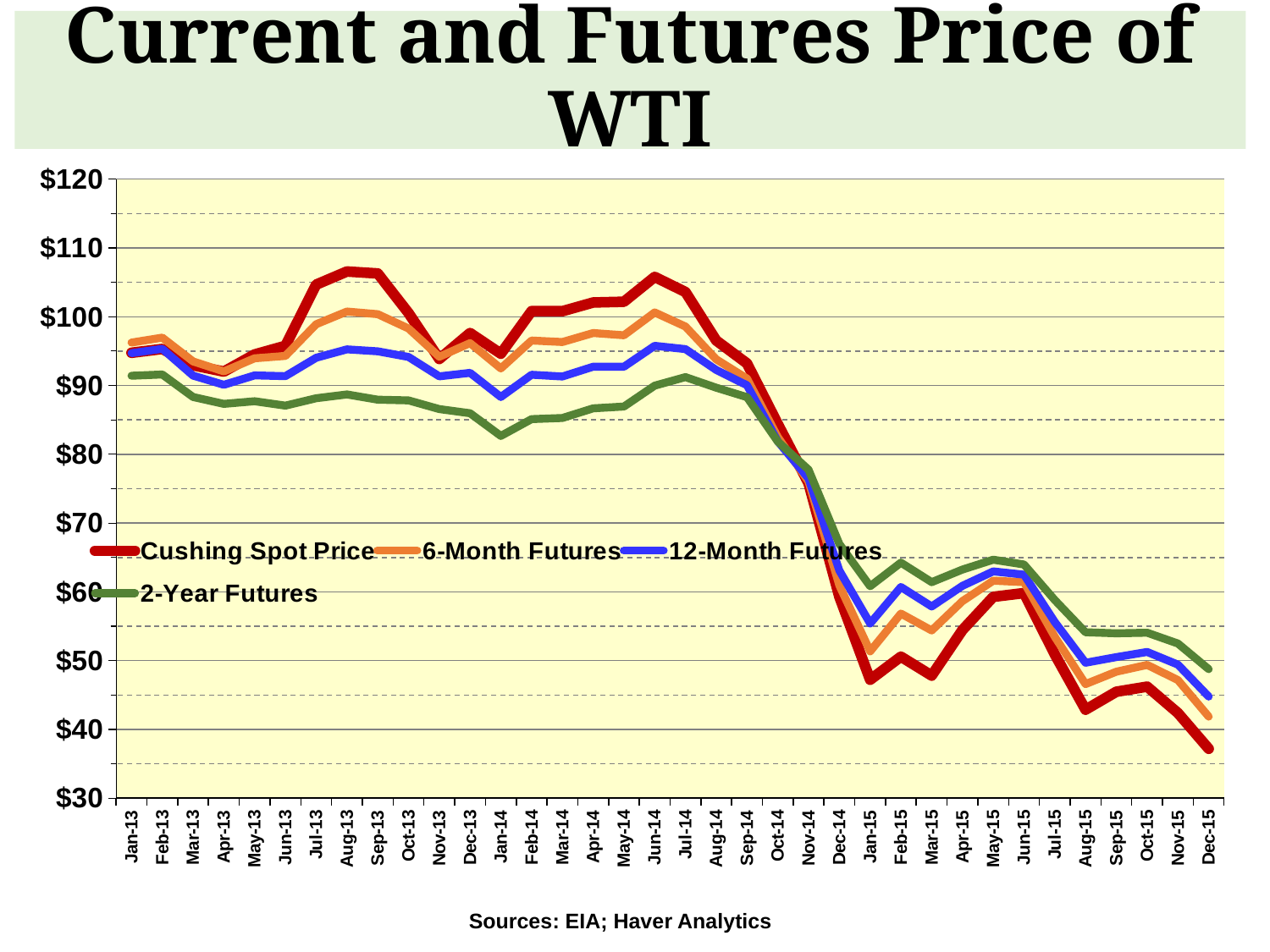
Is the Cushing Spot Price in Dec-15 greater or less than $40? less Is the 2-Year Futures value in Jan-14 greater or less than $90? less In Jan-15, which is higher: the Cushing Spot Price or the 2-Year Futures? 2-Year Futures Is the Cushing Spot Price in Aug-13 greater or less than $100? greater How many series does the legend list? 4 How many months are labelled along the x axis? 36 Does the Cushing Spot Price rise or fall between Jun-14 and Jan-15? Fall What is the title of the chart? Current and Futures Price of WTI Which series has the lowest value in Aug-13? 2-Year Futures Which series has the highest value in Dec-15? 2-Year Futures What kind of chart is shown on the slide? Line chart